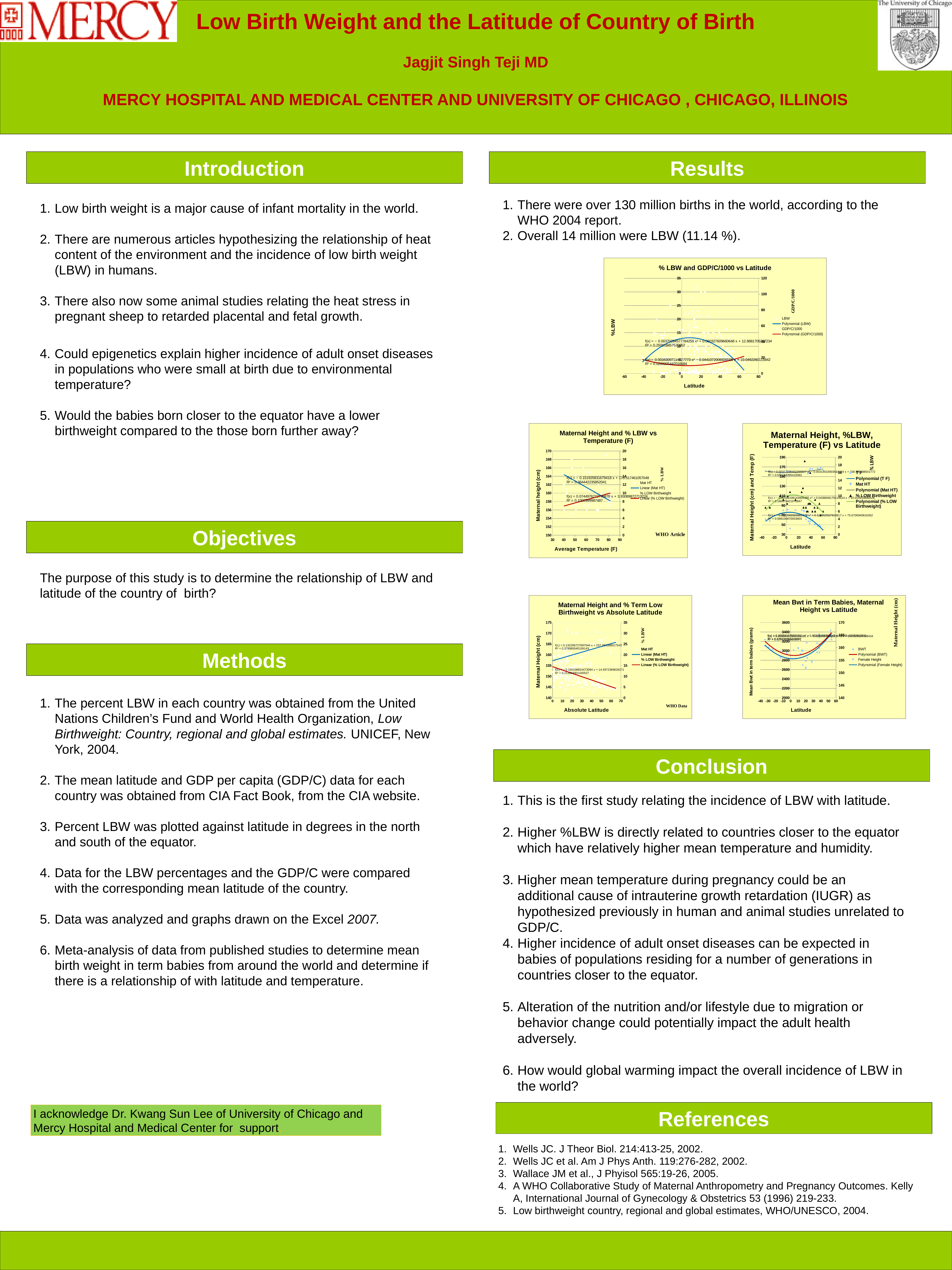
In the 'Maternal Height and % LBW vs Temperature (F)' chart, does the linear trendline for Mat HT rise or fall as average temperature increases? fall In the 'Maternal Height and % Term Low Birthweight vs Absolute Latitude' chart, does the linear trendline for % LOW Birthweight rise or fall as absolute latitude increases? fall How many series does the legend list in the 'Maternal Height and % LBW vs Temperature (F)' chart? 4 How many series does the legend list in the 'Mean Bwt in Term Babies, Maternal Height vs Latitude' chart? 4 How many series does the legend list in the 'Maternal Height, %LBW, Temperature (F) vs Latitude' chart? 5 In the 'Maternal Height and % Term Low Birthweight vs Absolute Latitude' chart, does the linear trendline for Mat HT rise or fall as absolute latitude increases? rise What kind of chart is the '% LBW and GDP/C/1000 vs Latitude' chart? scatter chart What is the left y-axis label of the 'Mean Bwt in Term Babies, Maternal Height vs Latitude' chart? Mean Bwt in term babies (grams) What is the x-axis label of the 'Maternal Height and % LBW vs Temperature (F)' chart? Average Temperature (F) What kind of chart is the 'Mean Bwt in Term Babies, Maternal Height vs Latitude' chart? scatter chart